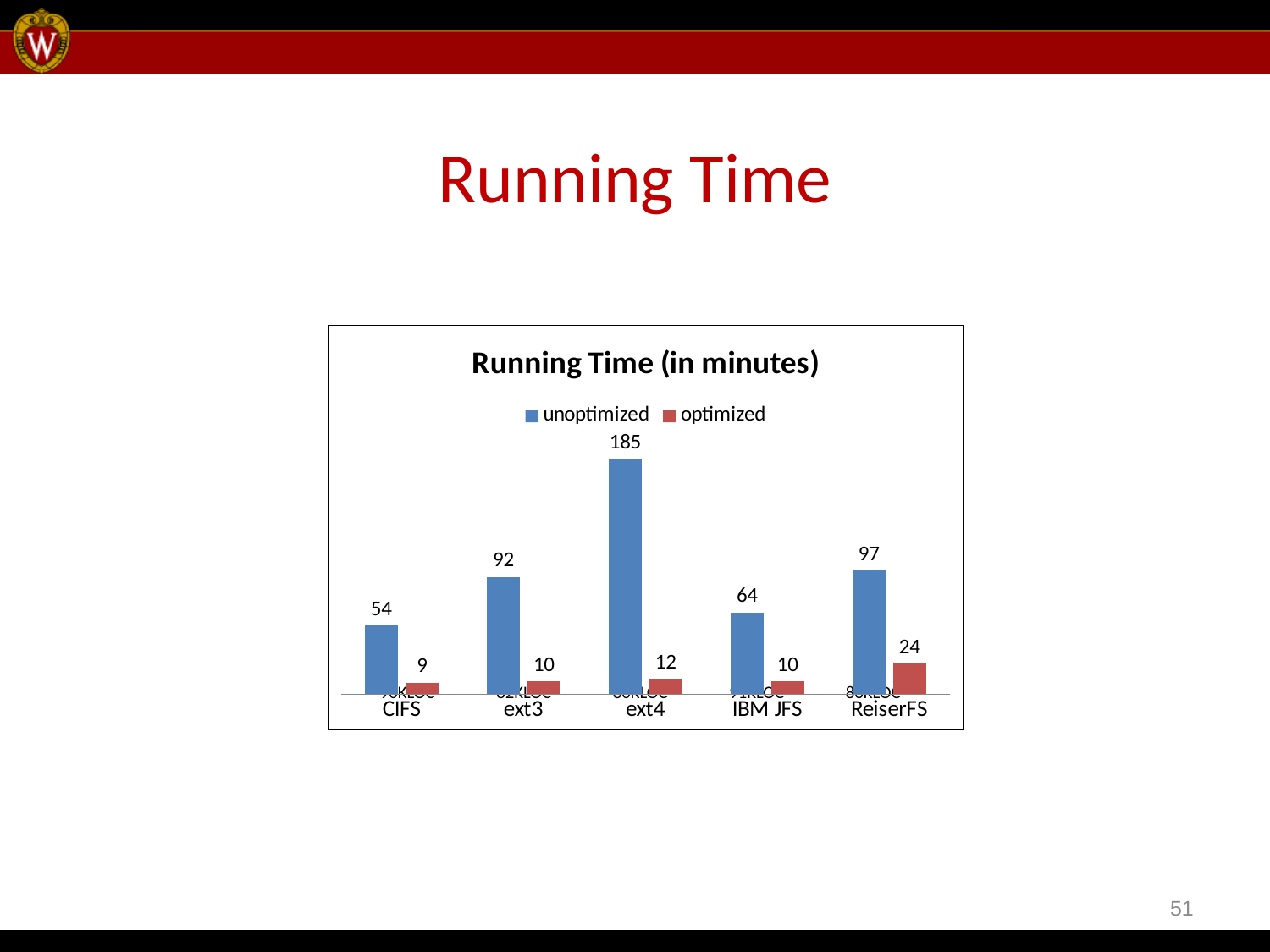
Which file system has the highest unoptimized running time? ext4 What is the optimized running time for ext3? 10 Which file system has the lowest optimized running time? CIFS Which is larger, the unoptimized running time for ext3 or for ReiserFS? ReiserFS How many series does the legend list? 2 What is the optimized running time for ReiserFS? 24 What kind of chart is shown? bar chart What is the unoptimized running time for CIFS? 54 How many file systems are shown on the x axis? 5 What is the unoptimized running time for ext4? 185 What is the difference between the unoptimized and optimized running times for ext4? 173 What is the title of the chart? Running Time (in minutes)